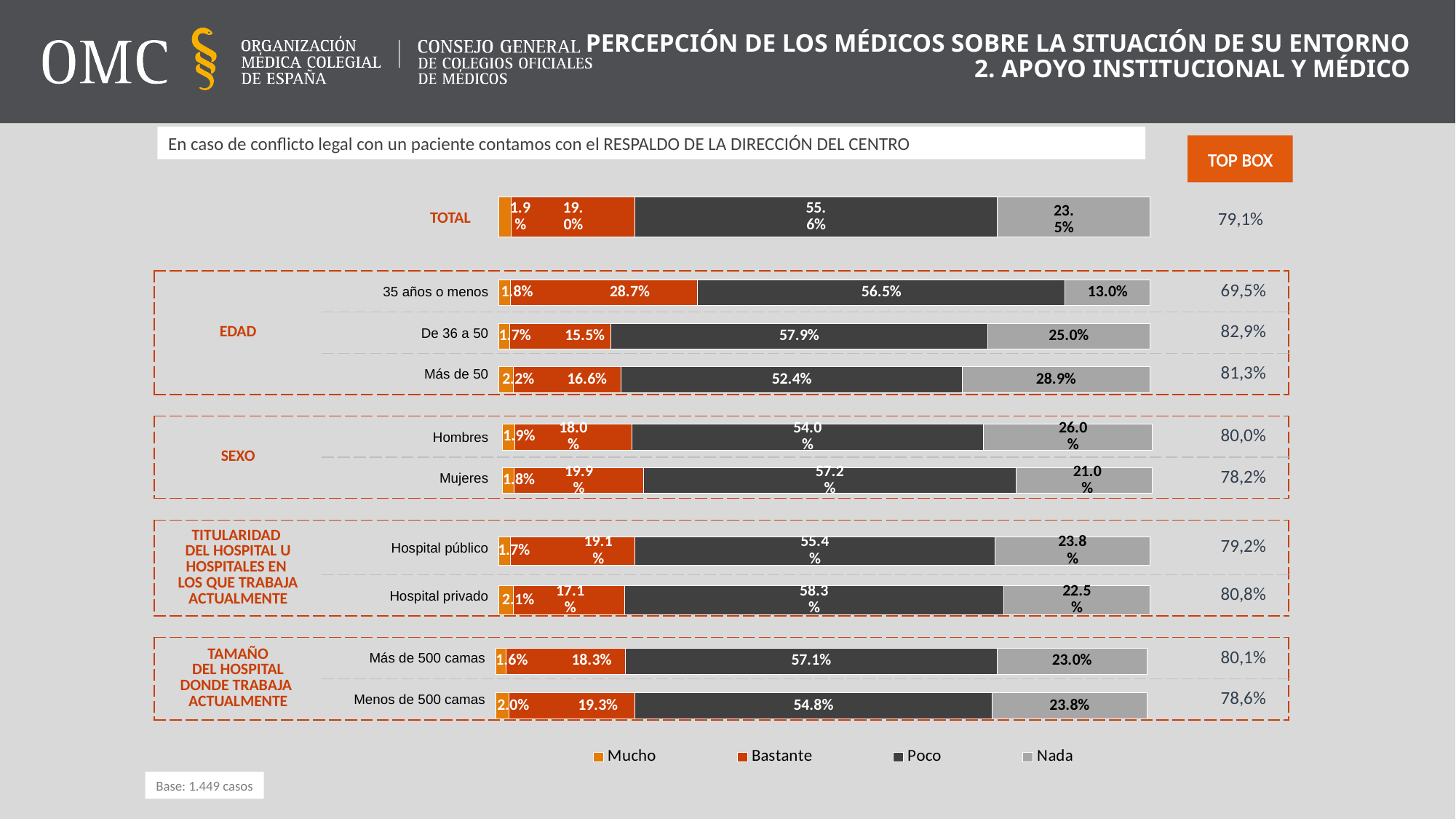
Which category has the highest Nada value? Más de 50 What is the value of the Nada segment for Más de 50? 28.9% What is the TOP BOX value shown for Hospital privado? 80,8% How many category bars are plotted in the chart, including TOTAL? 10 Which has a larger Bastante value, Hombres or Mujeres? Mujeres How many series does the legend list? 4 What is the value of the Bastante segment for 35 años o menos? 28.7% What is the difference between the Poco values for Hospital privado and Hospital público? 2.9% What is the value of the Poco segment for De 36 a 50? 57.9% What kind of chart is shown on the slide? Stacked bar chart Which category has the lowest Nada value? 35 años o menos What are the four legend entries of the chart? Mucho, Bastante, Poco, Nada